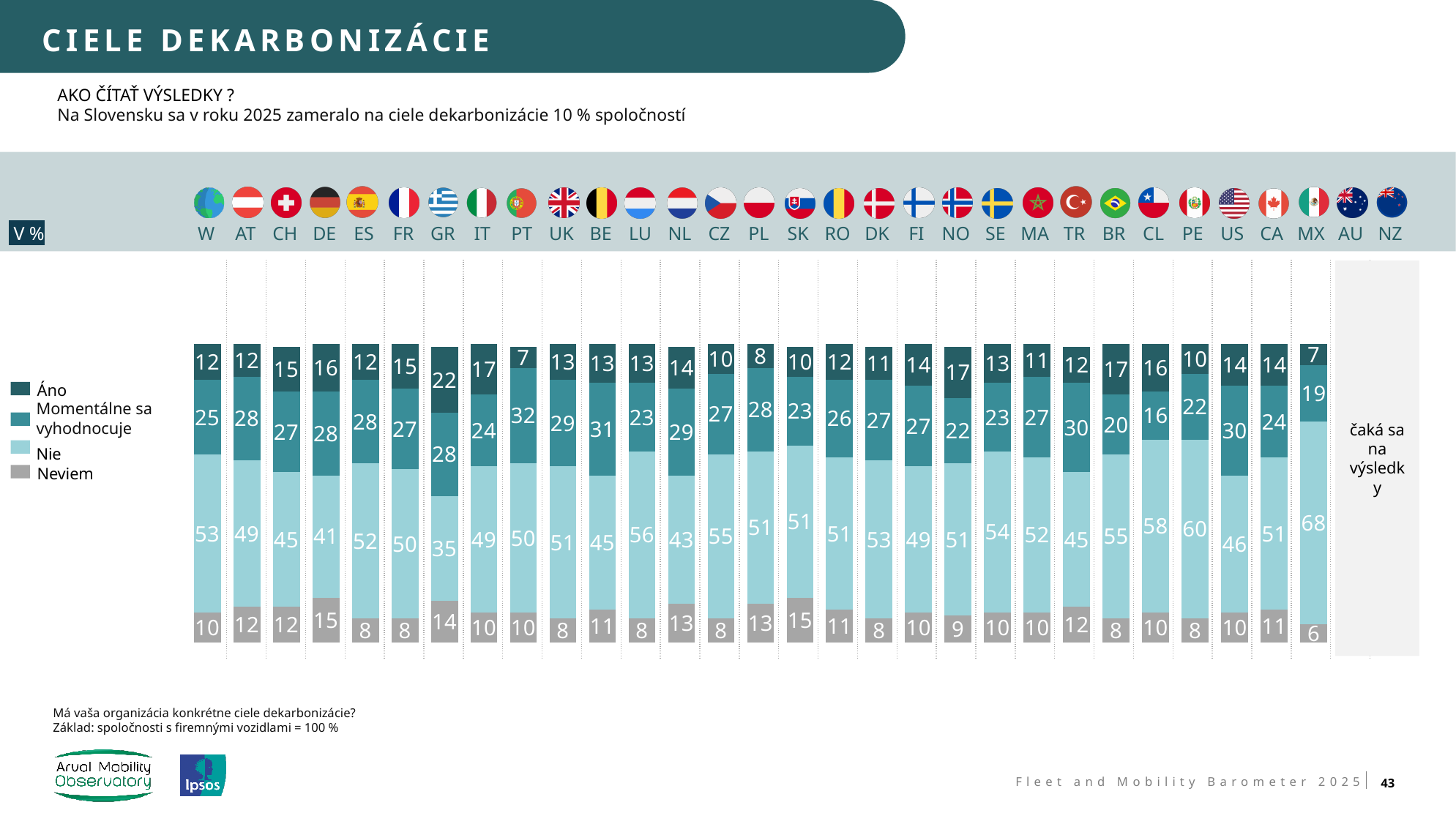
How many series does the legend list? 4 Which country has the lowest 'Neviem' value? MX What is the difference between the 'Nie' values for MX and W? 15 What is the total of the stacked bar for W? 100 Which is larger, the 'Áno' value for DE or the 'Áno' value for PL? DE What is the 'Momentálne sa vyhodnocuje' value for PT? 32 Which two countries are marked as awaiting results ('čaká sa na výsledky') instead of showing bars? AU and NZ Which country has the highest 'Áno' value? GR What is the 'Nie' value for MX? 68 Which country has the lowest 'Nie' value? GR What is the 'Áno' value for SK? 10 What type of chart is shown on the slide? stacked bar chart